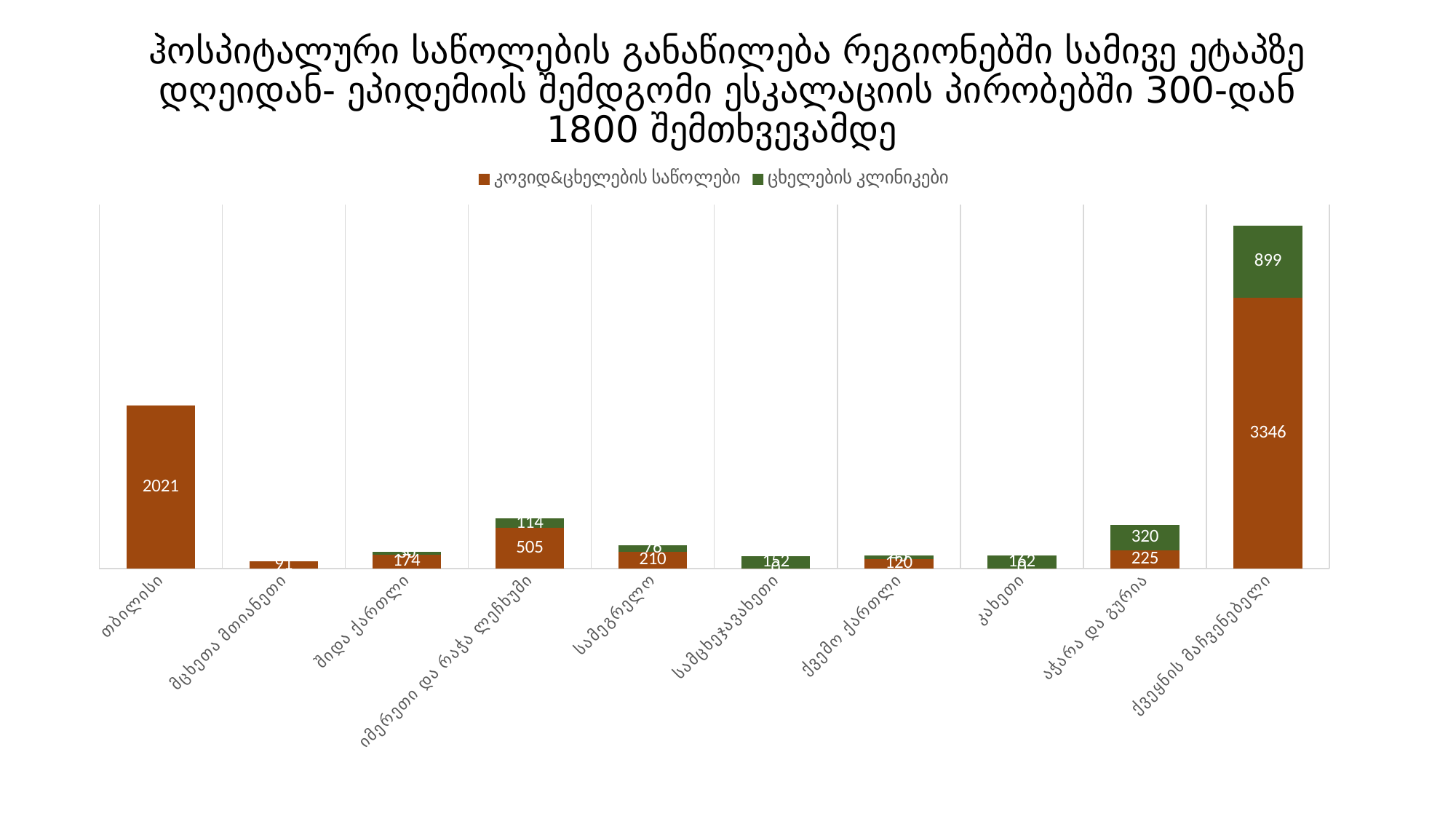
What is the value of კოვიდ&ცხელების საწოლები for იმერეთი და რაჭა ლეჩხუმი? 505 What is the total of the stacked bar for ქვეყნის მაჩვენებელი? 4245 How many series does the legend list? 2 What is the value of ცხელების კლინიკები for აჭარა და გურია? 320 What is the value of ცხელების კლინიკები for ქვეყნის მაჩვენებელი? 899 What kind of chart is shown on the slide? bar chart Which category has the tallest stacked bar? ქვეყნის მაჩვენებელი Which is larger: the კოვიდ&ცხელების საწოლები value for თბილისი or for აჭარა და გურია? თბილისი How many categories are shown along the x axis? 10 What is the total of the stacked bar for სამეგრელო? 286 What is the value of კოვიდ&ცხელების საწოლები for თბილისი? 2021 What is the difference between the კოვიდ&ცხელების საწოლები values for ქვეყნის მაჩვენებელი and თბილისი? 1325